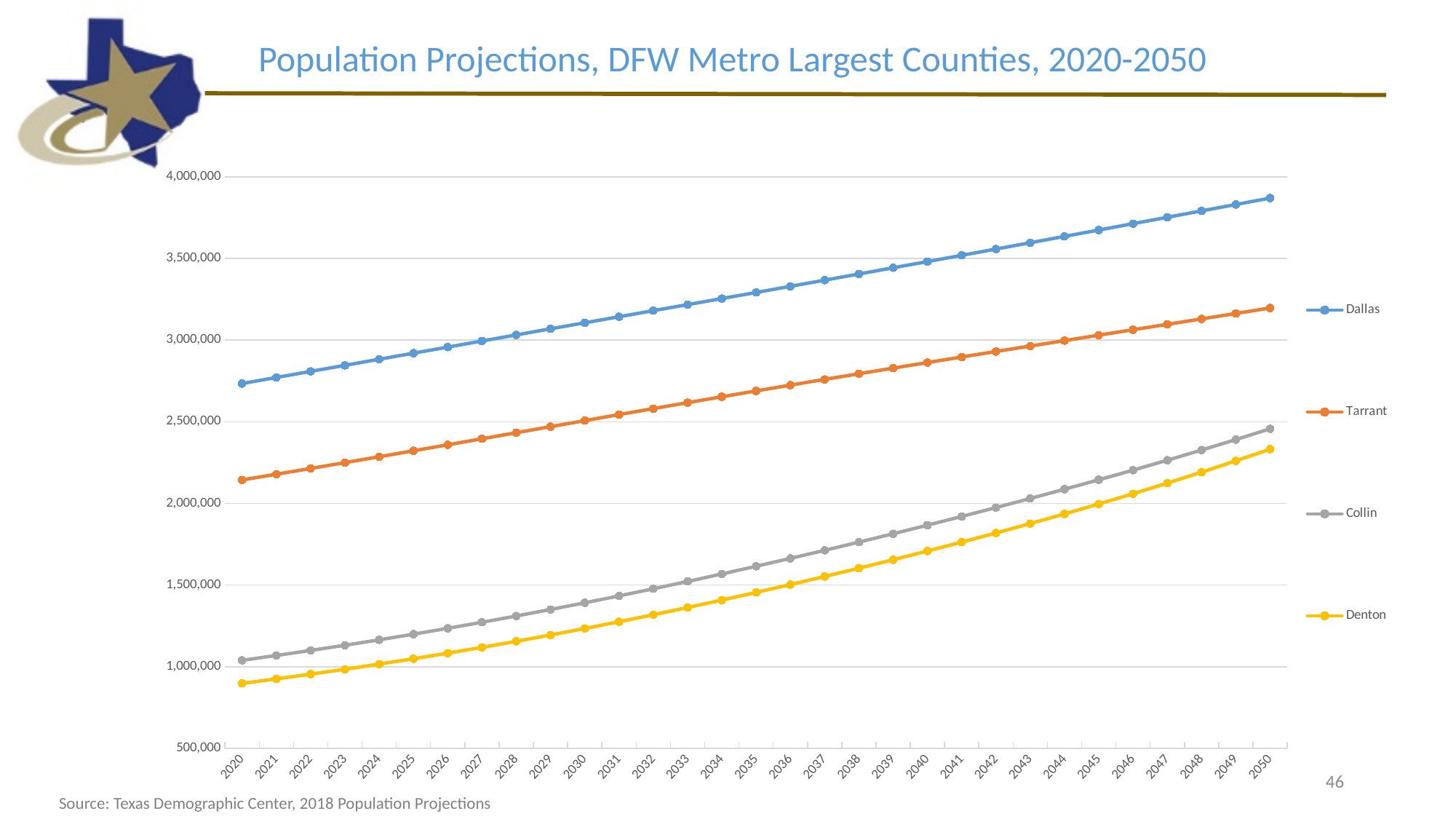
Which county has the highest projected population in 2050? Dallas How many series does the legend list? 4 Do the projected populations rise or fall from 2020 to 2050? Rise Is the value for Dallas in 2020 greater or less than 2,500,000? greater In 2050, which is larger: the projected population of Collin or Denton? Collin What kind of chart is shown on the slide? Line chart Is the value for Denton in 2020 greater or less than 1,000,000? less Which county has the lowest projected population in 2020? Denton How many years are plotted along the x axis? 31 What is the title of the chart? Population Projections, DFW Metro Largest Counties, 2020-2050 Is the value for Tarrant in 2050 greater or less than 3,000,000? greater